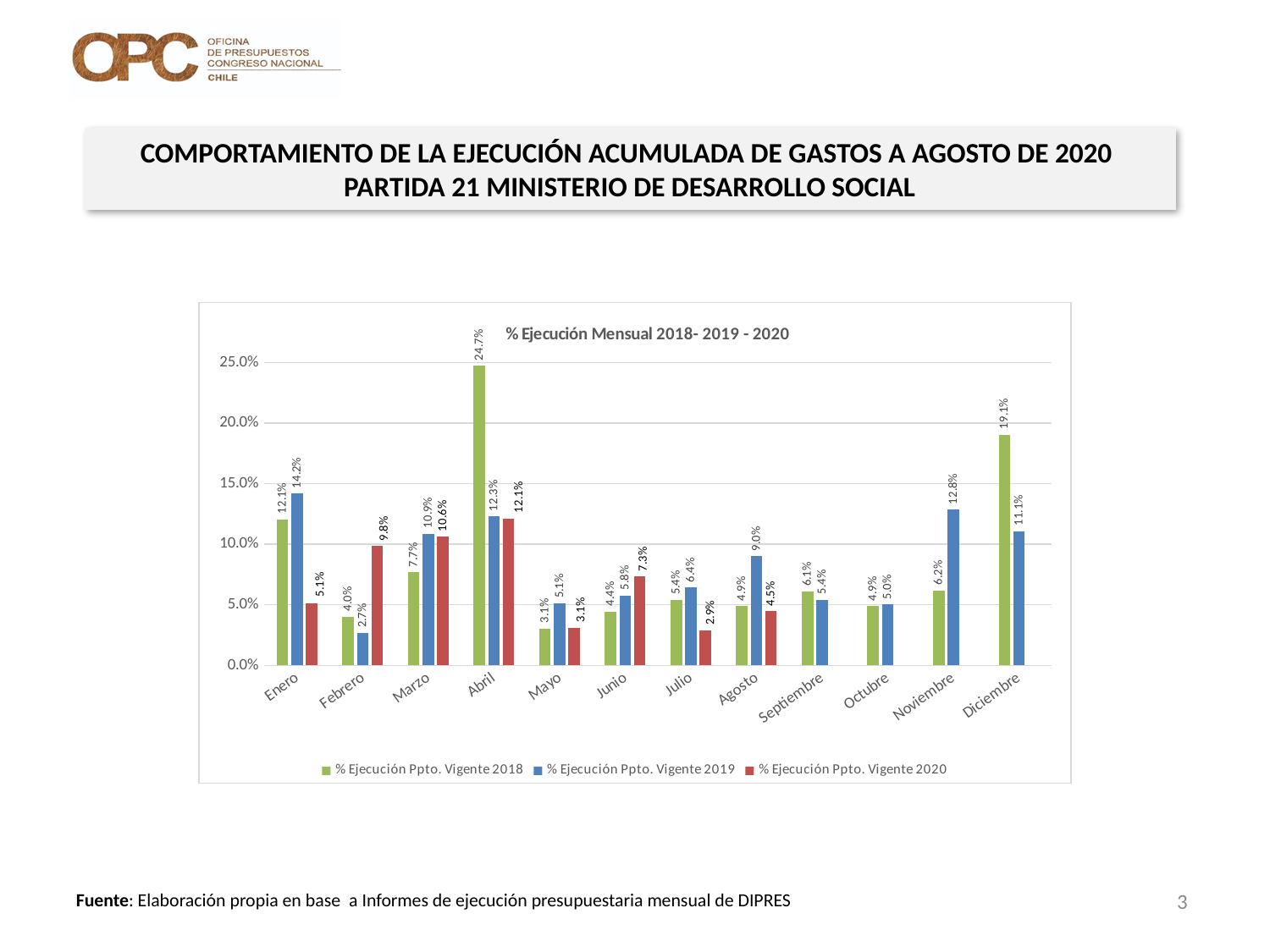
What is the value for % Ejecución Ppto. Vigente 2018 in Abril? 24.7% Which month has the lowest value for % Ejecución Ppto. Vigente 2020? Julio What is the title of the chart? % Ejecución Mensual 2018- 2019 - 2020 Which month has the highest value for % Ejecución Ppto. Vigente 2019? Enero What is the value for % Ejecución Ppto. Vigente 2019 in Noviembre? 12.8% What is the value for % Ejecución Ppto. Vigente 2020 in Febrero? 9.8% In Agosto, which series has the larger value: % Ejecución Ppto. Vigente 2019 or % Ejecución Ppto. Vigente 2020? % Ejecución Ppto. Vigente 2019 What kind of chart is shown on the slide? Bar chart What is the difference between the 2018 and 2019 values in Diciembre? 8.0% Is the value for % Ejecución Ppto. Vigente 2018 in Diciembre greater or less than 15.0%? greater How many months are shown on the x axis? 12 How many series does the legend list? 3